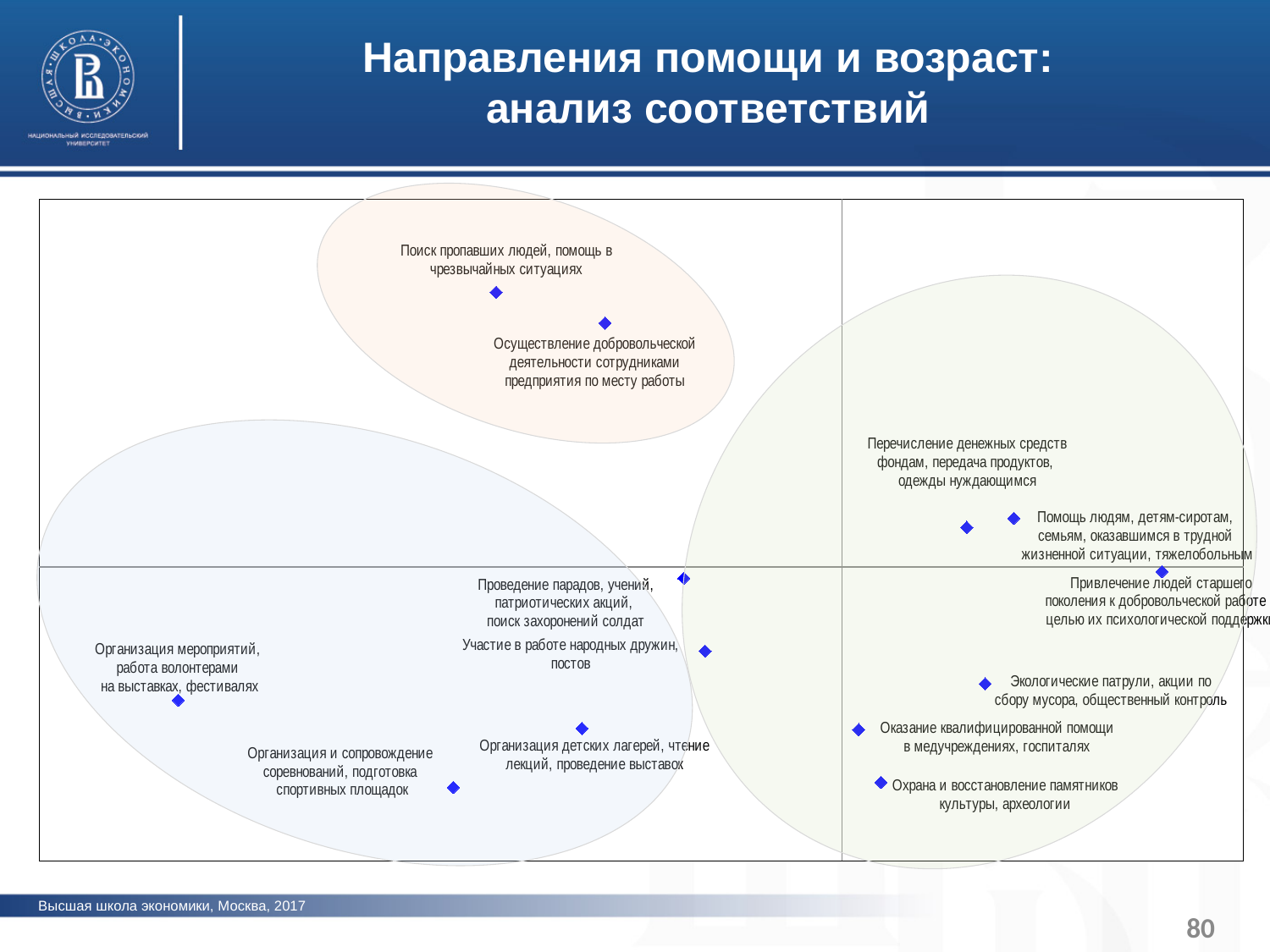
How many data points lie inside the top ellipse of the chart? 2 What is the title of the slide containing the chart? Направления помощи и возраст: анализ соответствий Which category is plotted highest on the chart? Поиск пропавших людей, помощь в чрезвычайных ситуациях Which category is plotted lowest on the chart? Организация и сопровождение соревнований, подготовка спортивных площадок Which is plotted higher on the chart: "Экологические патрули, акции по сбору мусора, общественный контроль" or "Охрана и восстановление памятников культуры, археологии"? Экологические патрули, акции по сбору мусора, общественный контроль How many data points are plotted on the chart? 13 Which category is plotted furthest to the right on the chart? Привлечение людей старшего поколения к добровольческой работе с целью их психологической поддержки Which category is plotted furthest to the left on the chart? Организация мероприятий, работа волонтерами на выставках, фестивалях How many shaded ellipses (groups) are drawn on the chart? 3 Which is plotted further to the left: "Проведение парадов, учений, патриотических акций, поиск захоронений солдат" or "Оказание квалифицированной помощи в медучреждениях, госпиталях"? Проведение парадов, учений, патриотических акций, поиск захоронений солдат What kind of chart is shown on the slide? Scatter chart